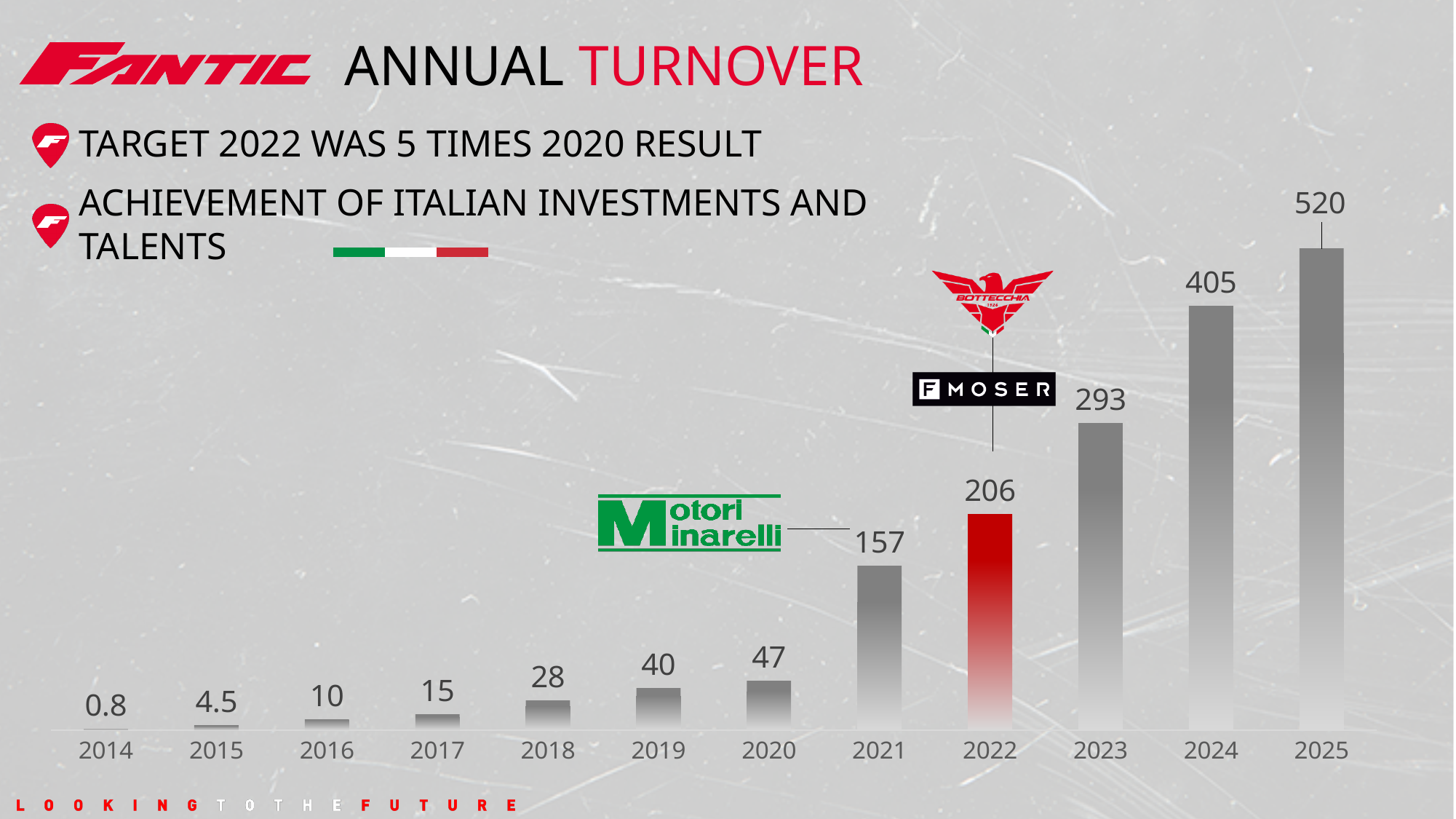
What is the annual turnover value shown for 2020? 47 Which year has the highest annual turnover value on the chart? 2025 How many years are shown on the x axis of the chart? 12 What is the difference between the 2025 value and the 2024 value? 115 What kind of chart is used to show the annual turnover? bar chart What is the annual turnover value shown for 2022? 206 What is the difference between the 2022 value and the 2021 value? 49 What is the annual turnover value shown for 2014? 0.8 Which year's bar is coloured red instead of grey? 2022 Do the annual turnover values rise or fall from 2014 to 2025? rise Which is larger, the value for 2019 or the value for 2020? 2020 Which year has the lowest annual turnover value on the chart? 2014